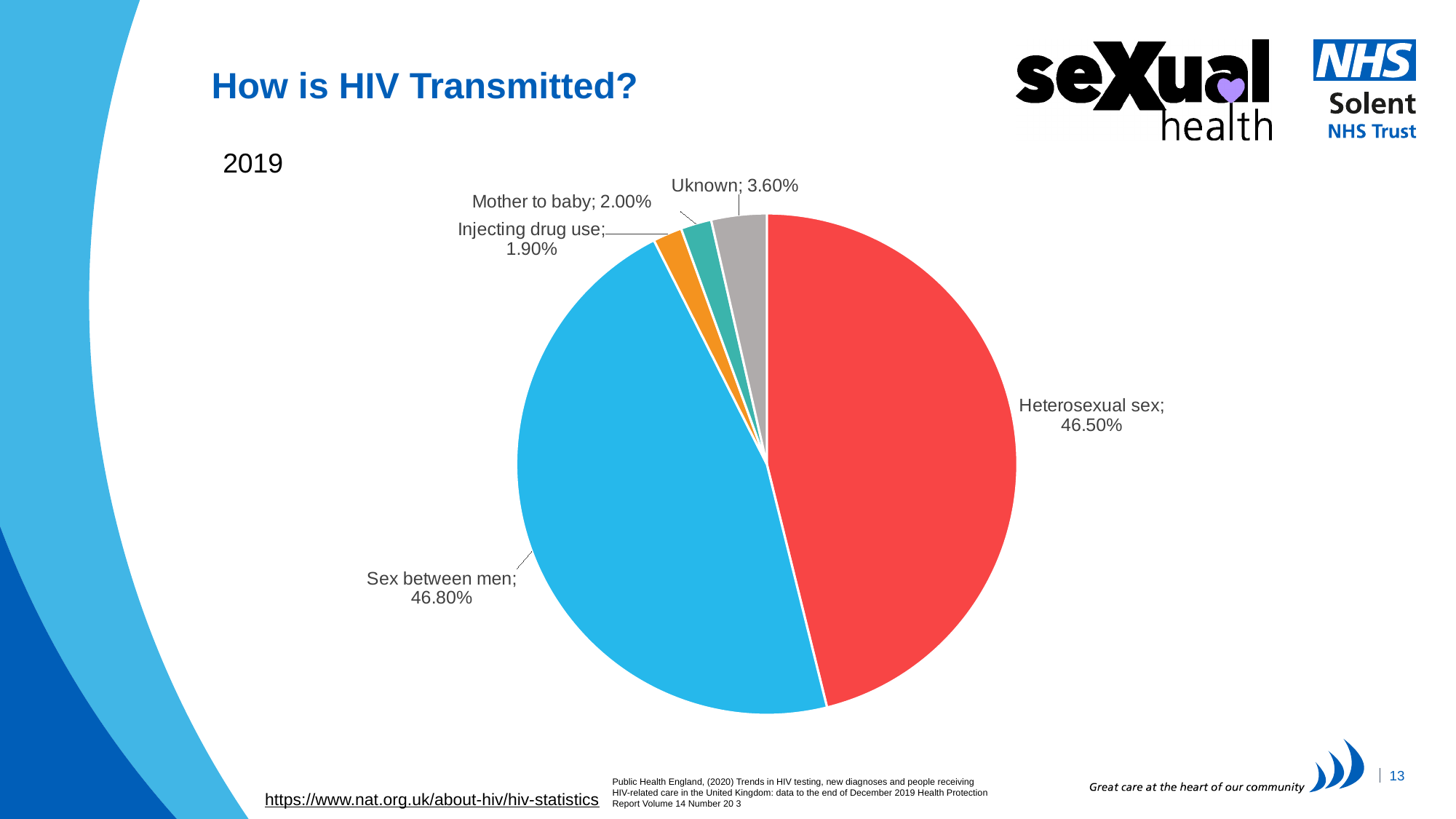
What percentage is shown for the Uknown slice? 3.60% What is the difference between the Sex between men and Heterosexual sex percentages? 0.30% Which category has the largest share of the pie? Sex between men What percentage of HIV transmission is attributed to Sex between men? 46.80% What percentage is shown for Injecting drug use? 1.90% Which category has the smallest share of the pie? Injecting drug use Which year does the pie chart refer to? 2019 What kind of chart is shown on the slide? pie chart How many slices does the pie chart have? 5 Which is larger, the Uknown share or the Mother to baby share? Uknown What percentage is shown for Mother to baby? 2.00% What percentage of HIV transmission is attributed to Heterosexual sex? 46.50%